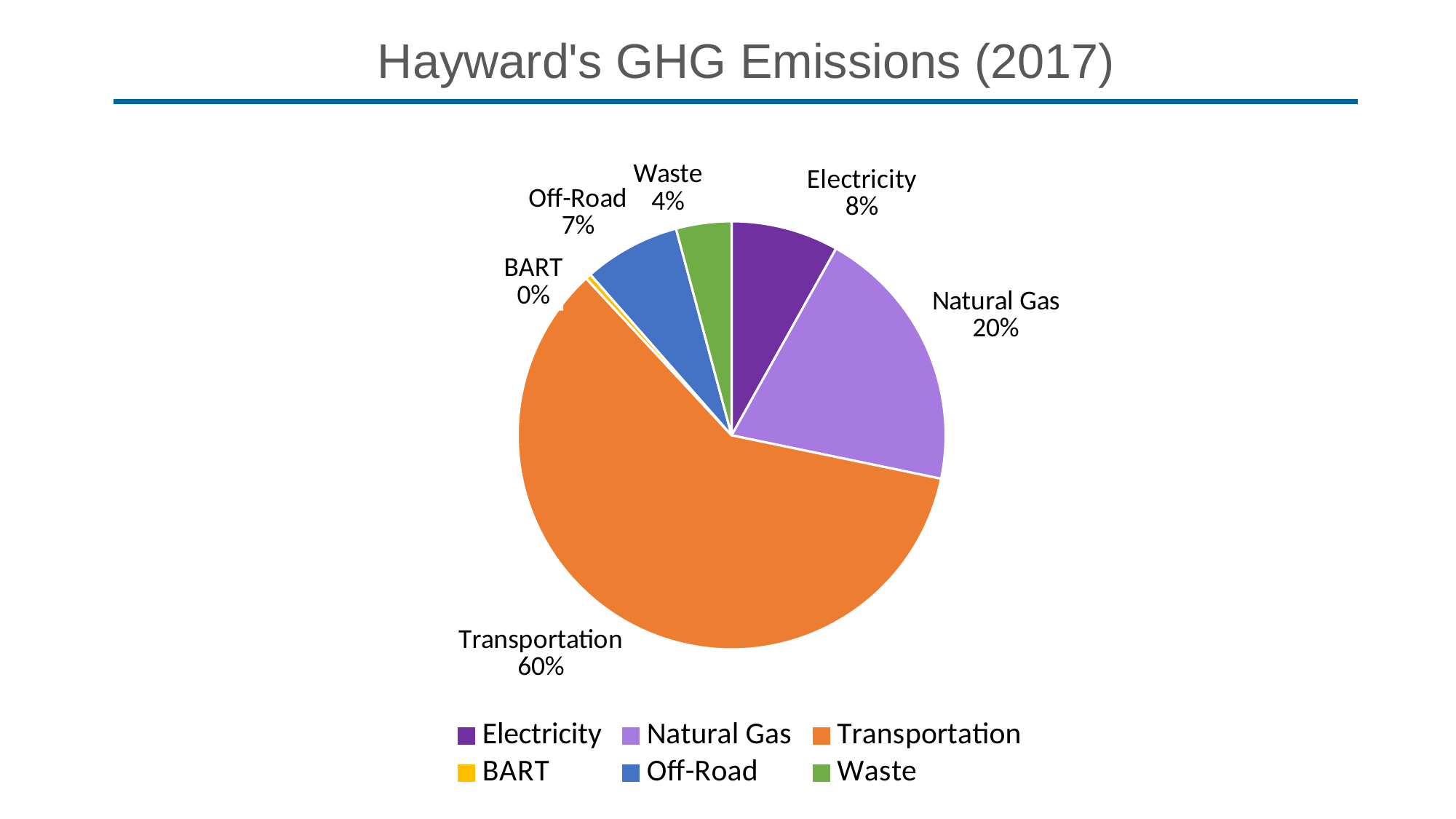
Which category has the largest share of emissions? Transportation How many categories does the legend list? 6 What type of chart is shown on the slide? Pie chart What share of Hayward's GHG emissions comes from Transportation? 60% What is the difference in percentage points between Transportation and Natural Gas? 40 What is the share for Electricity? 8% What is the share for Waste? 4% Which category has the smallest share of emissions? BART What percentage is shown for BART? 0% What percentage does Off-Road account for? 7% Which is larger, the share for Electricity or the share for Off-Road? Electricity What percentage of emissions is attributed to Natural Gas? 20%